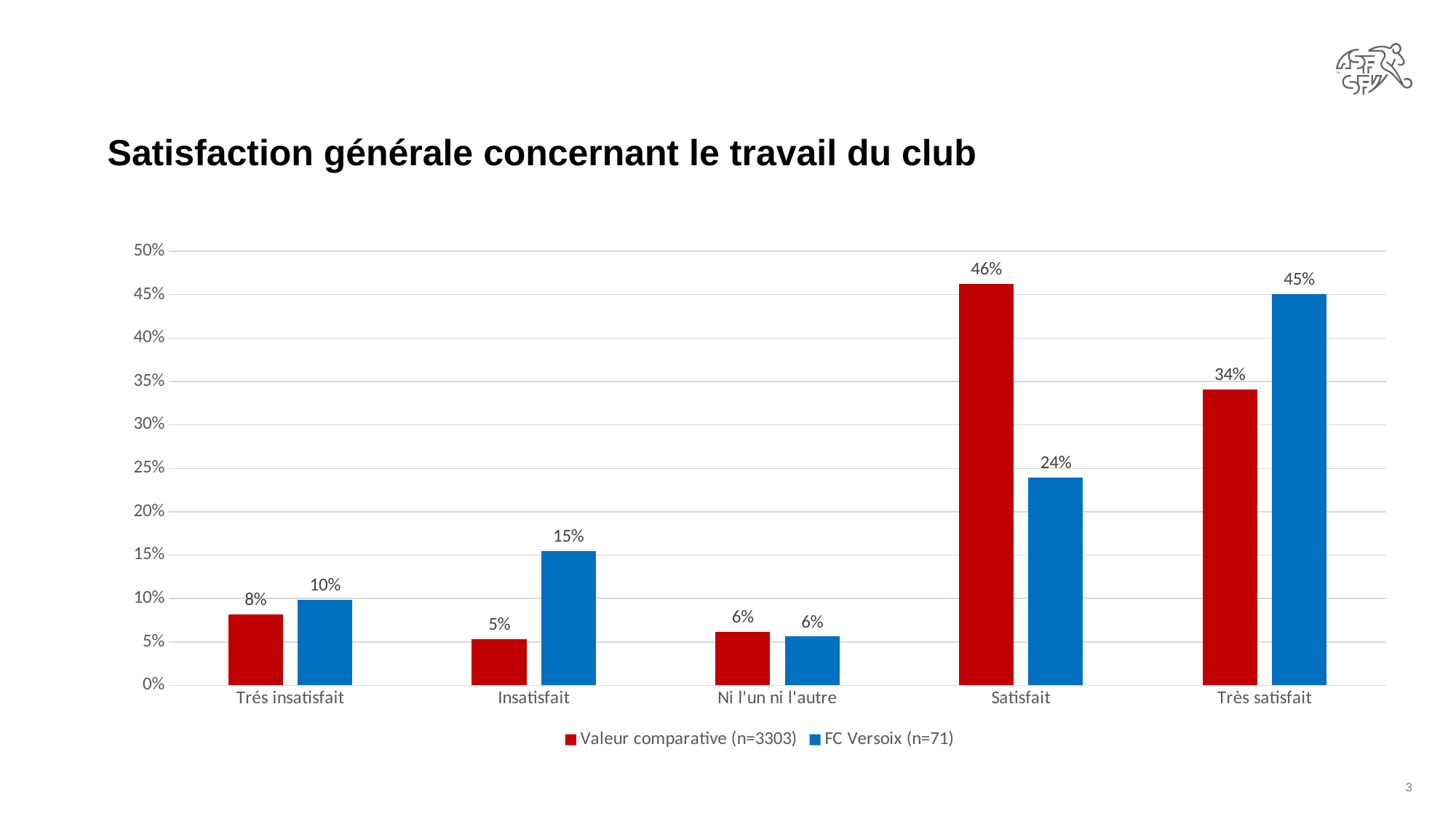
Is the value for FC Versoix (n=71) in the Satisfait category greater or less than 25%? less What is the difference between Valeur comparative (n=3303) and FC Versoix (n=71) in the Satisfait category? 22% What is the value for Valeur comparative (n=3303) in the Très satisfait category? 34% How many categories are shown on the x axis? 5 Which category has the highest value for Valeur comparative (n=3303)? Satisfait What is the value for FC Versoix (n=71) in the Satisfait category? 24% Which category has the lowest value for Valeur comparative (n=3303)? Insatisfait What kind of chart is shown on the slide? bar chart What is the value for FC Versoix (n=71) in the Insatisfait category? 15% How many series does the legend list? 2 Which series has the larger value in the Très satisfait category? FC Versoix (n=71) Which category has the highest value for FC Versoix (n=71)? Très satisfait